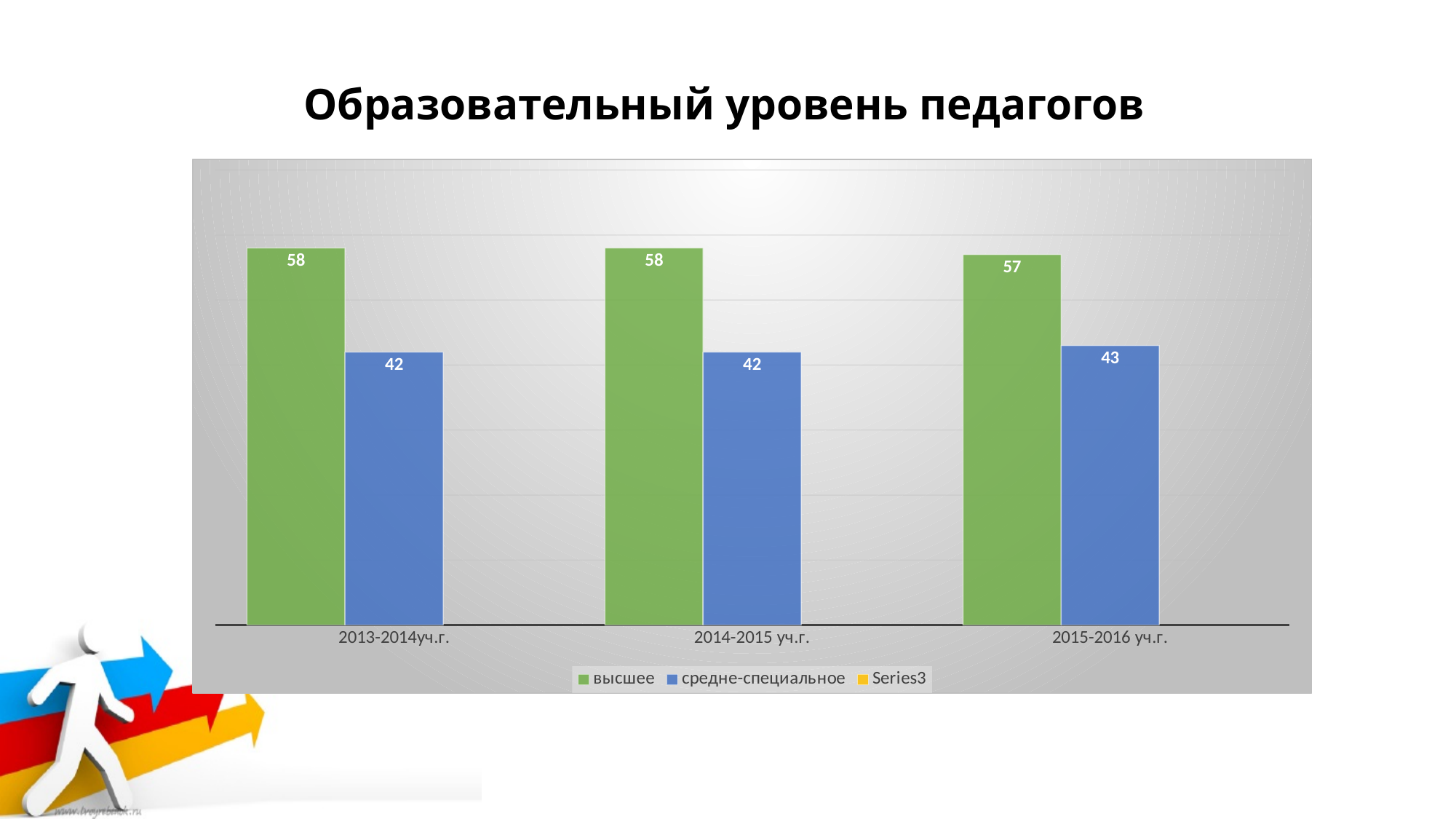
How many year categories are shown on the x axis? 3 In which year is the value for высшее lowest? 2015-2016 уч.г. What is the title of the slide? Образовательный уровень педагогов Which is larger in 2015-2016 уч.г., высшее or средне-специальное? высшее How many series does the legend list? 3 What is the value for средне-специальное in 2015-2016 уч.г.? 43 What is the value for высшее in 2015-2016 уч.г.? 57 What is the value for средне-специальное in 2014-2015 уч.г.? 42 What kind of chart is shown on the slide? bar chart What is the difference between высшее and средне-специальное in 2013-2014уч.г.? 16 In which year is the value for средне-специальное highest? 2015-2016 уч.г. What is the value for высшее in 2013-2014уч.г.? 58